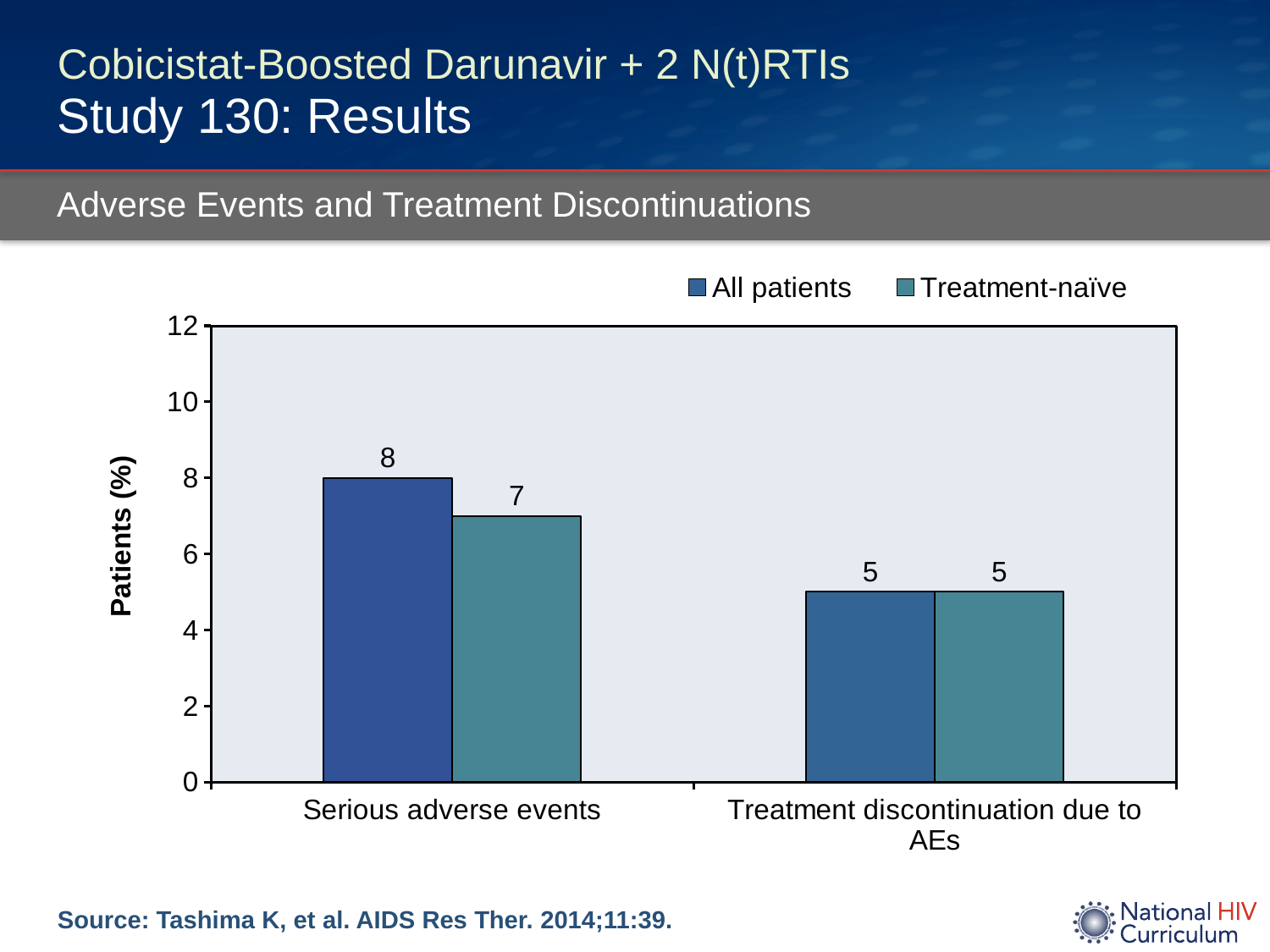
For serious adverse events, which series has the larger value: all patients or treatment-naïve? All patients Which category has the highest value for all patients? Serious adverse events Which category has the lowest value for treatment-naïve patients? Treatment discontinuation due to AEs How many series does the legend list? 2 What percentage of all patients had treatment discontinuation due to AEs? 5 What percentage of all patients had serious adverse events? 8 What is the difference between the all patients and treatment-naïve values for serious adverse events? 1 What kind of chart is shown on the slide? Bar chart What is the label of the y axis? Patients (%) What percentage of treatment-naïve patients had treatment discontinuation due to AEs? 5 What percentage of treatment-naïve patients had serious adverse events? 7 How many categories are shown on the x axis? 2